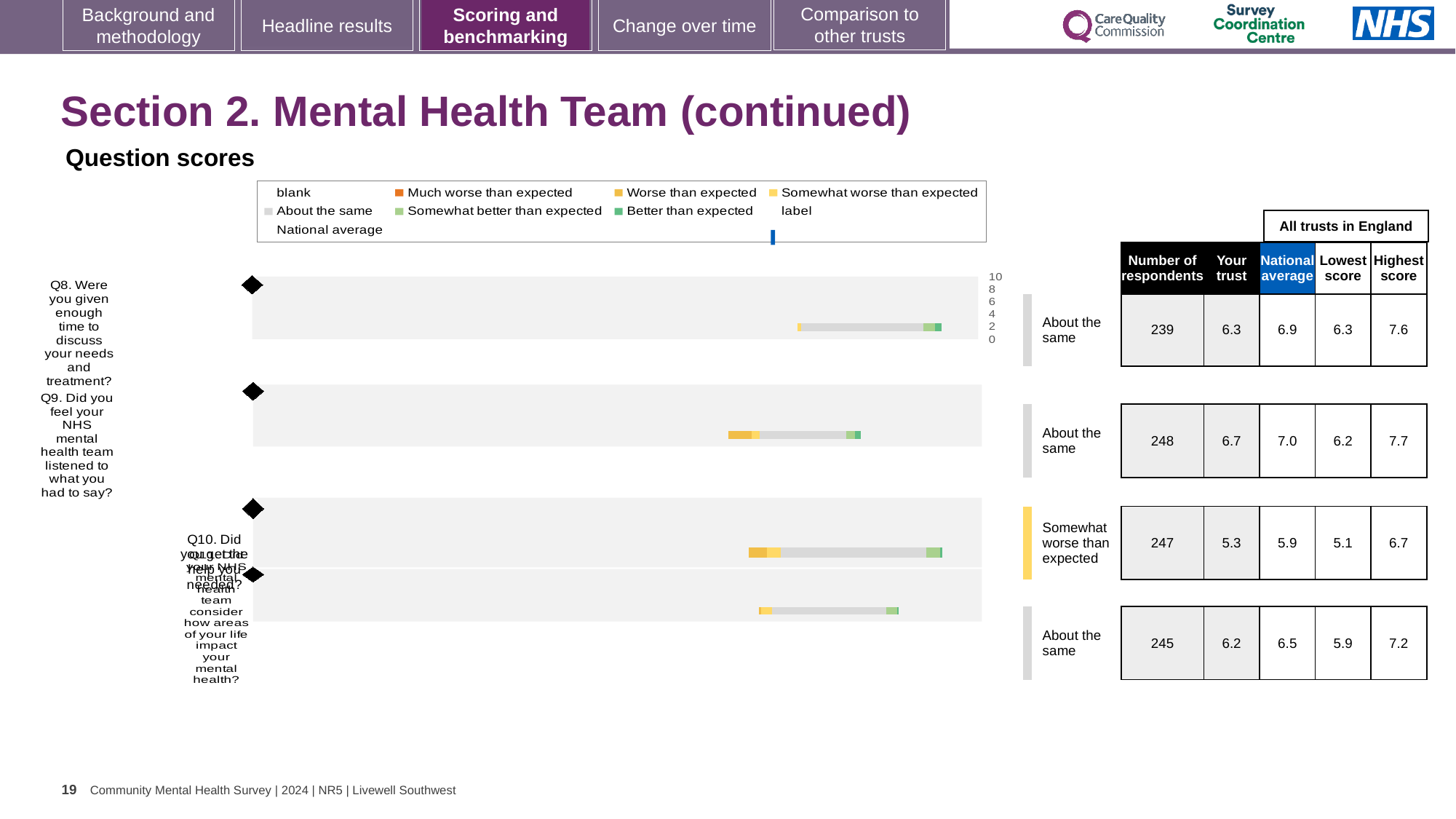
What kind of chart is used to show the question scores on this slide? bar chart What is the highest score among all trusts in England for Q9? 7.7 Which has the higher 'Your trust' score, Q8 or Q9? Q9 What is the lowest score among all trusts in England for Q10? 5.1 How many questions (bars) are plotted in the question scores chart? 4 What is the difference between the national average and the 'Your trust' score for Q8? 0.6 What is the national average score for Q10 (Did you get the help you needed?)? 5.9 What is the 'Your trust' score for Q9 (Did you feel your NHS mental health team listened to what you had to say?)? 6.7 What benchmark category is shown for Q10 (Did you get the help you needed?)? Somewhat worse than expected Which question has the lowest 'Your trust' score? Q10 What is the number of respondents for Q8 (Were you given enough time to discuss your needs and treatment?)? 239 Which question has the highest number of respondents? Q9